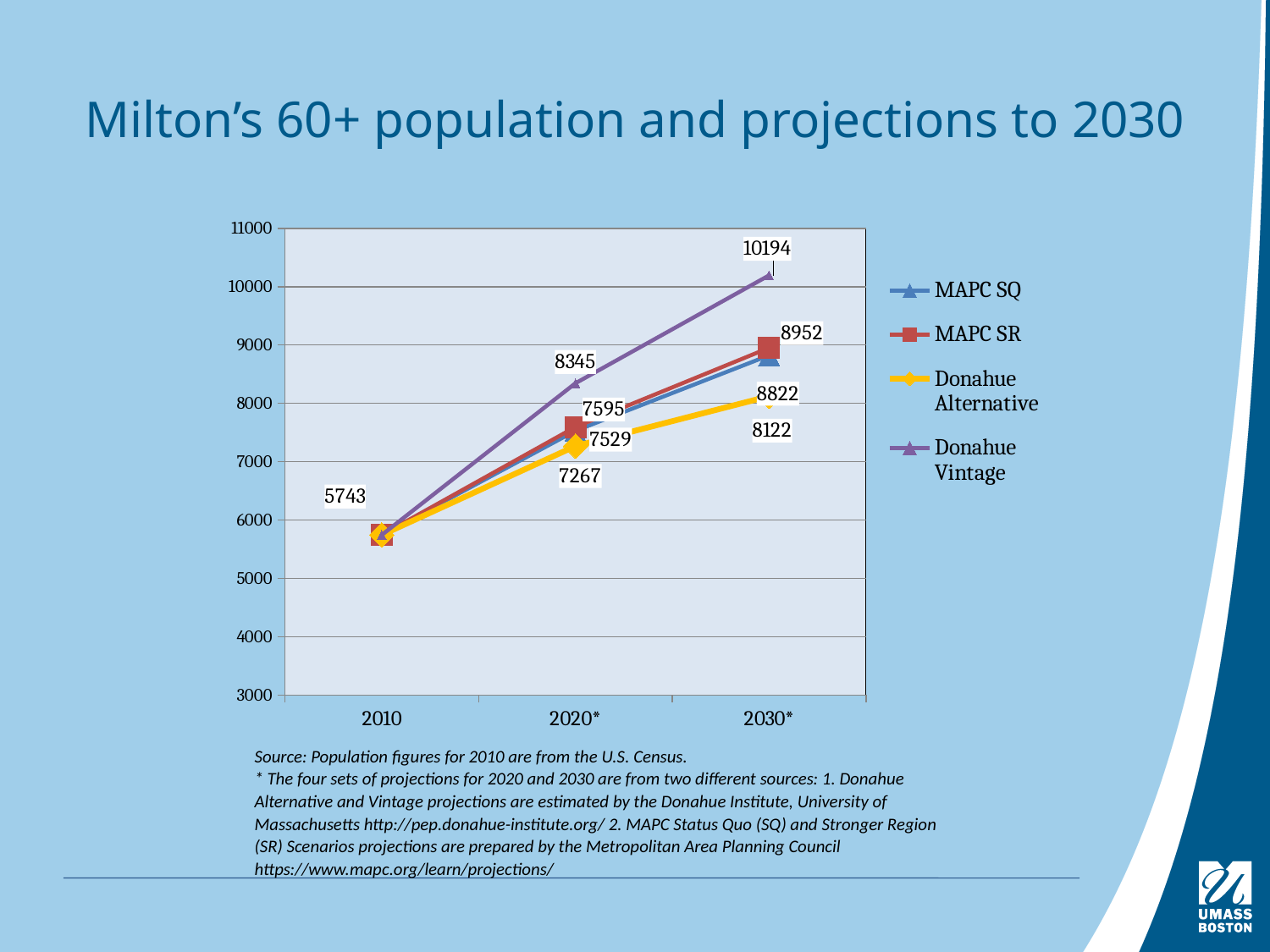
How many series does the legend list? 4 Which series has the highest value at 2030*? Donahue Vintage How many points are on the x axis? 3 What is the difference between the Donahue Vintage and MAPC SR projections for 2030*? 1242 Is the Donahue Vintage value for 2030* greater or less than 10000? greater What kind of chart is shown on the slide? line chart What is the 2010 value for Milton's 60+ population? 5743 Which series has the lowest value at 2030*? Donahue Alternative What is the Donahue Vintage projection for 2020*? 8345 What is the MAPC SR projection for 2030*? 8952 Do the values rise or fall from 2010 to 2030*? rise What is the Donahue Vintage projection for 2030*? 10194